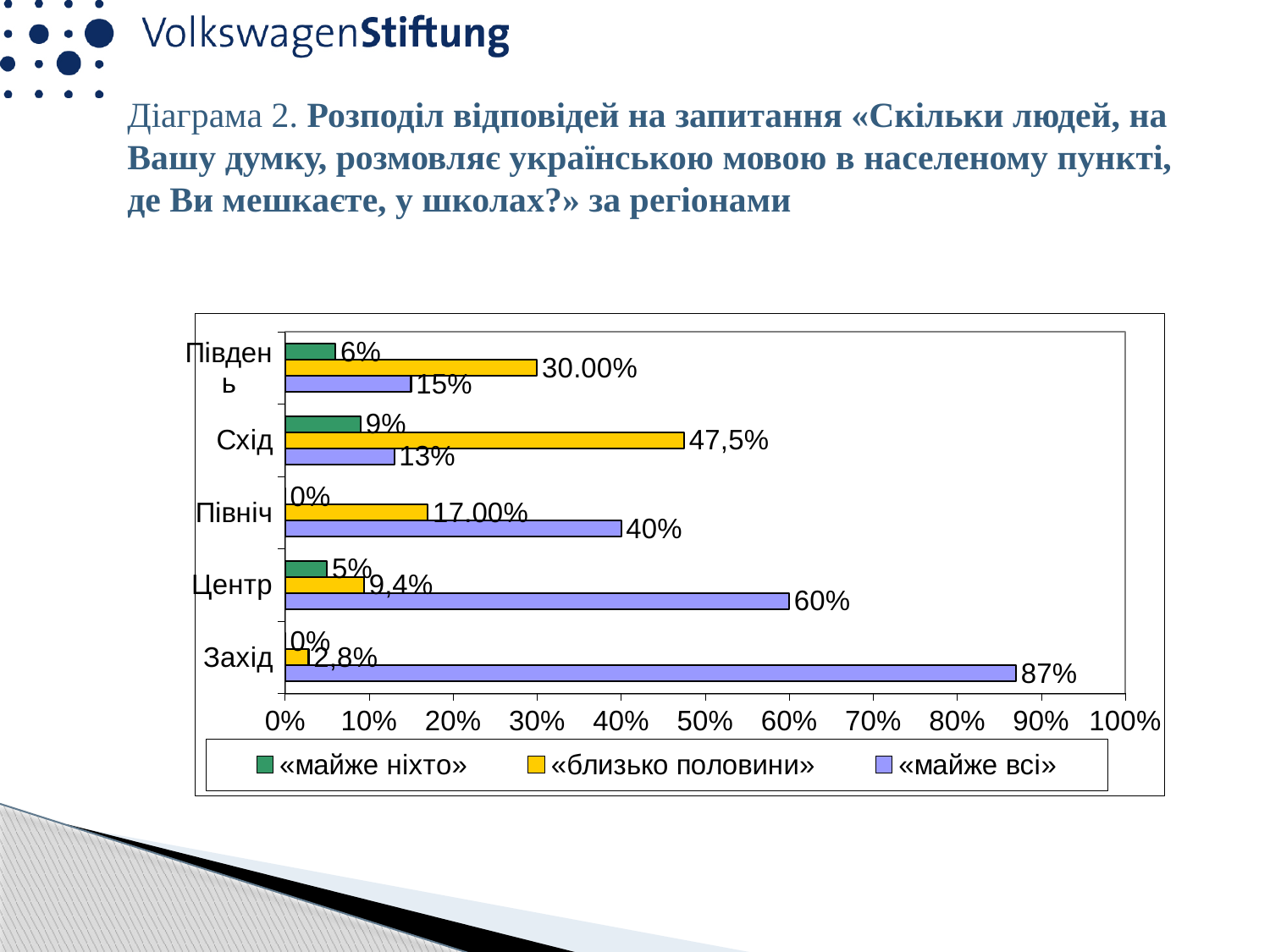
Which region has the highest value for «майже всі»? Захід How many series does the legend list? 3 Which is larger: «майже всі» in Північ or «майже всі» in Південь? Північ What is the value for «майже всі» in Захід? 87% What is the value for «близько половини» in Центр? 9,4% What is the difference between the «майже всі» values for Захід and Центр? 27% What kind of chart is shown on the slide? bar chart How many regions (categories) are shown on the chart? 5 What is the value for «майже ніхто» in Південь? 6% Which series is shown in yellow in the legend? «близько половини» Which region has the lowest value for «близько половини»? Захід What is the value for «близько половини» in Схід? 47,5%